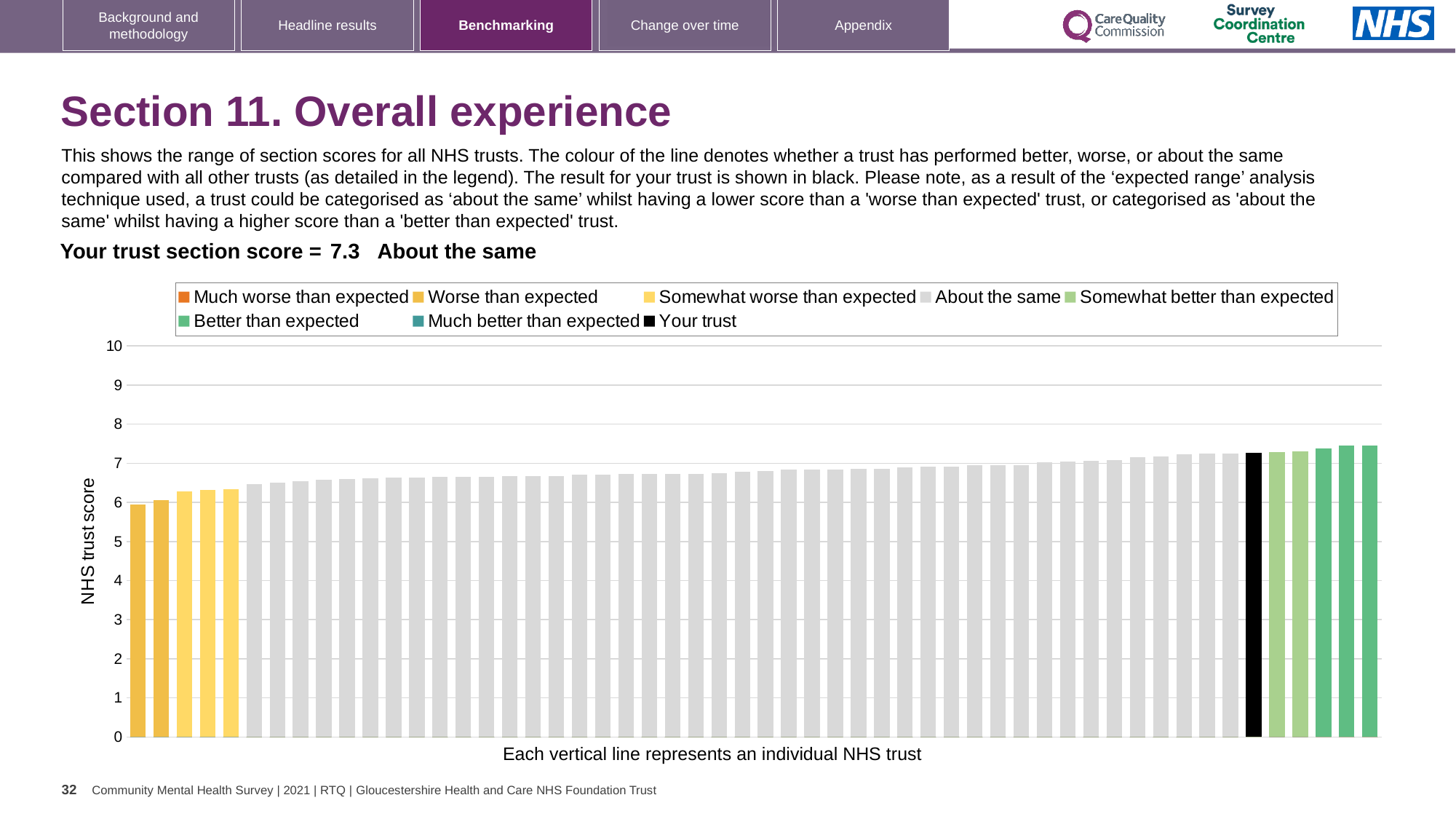
Do the bar values rise or fall from left to right along the x axis? Rise How many bars on the chart are coloured black? 1 Is the value for your trust (the black bar) greater or less than 7? greater What colour is the bar representing your trust? Black Which performance category is your trust placed in according to the slide? About the same Is the value of the shortest bar greater or less than 5? greater Is the value of the tallest bar greater or less than 8? less What kind of chart is shown on the slide? Bar chart What is the section score for your trust shown on the slide? 7.3 What is the highest value shown on the vertical axis? 10 What is the label on the vertical axis of the chart? NHS trust score How many entries does the chart legend list? 8